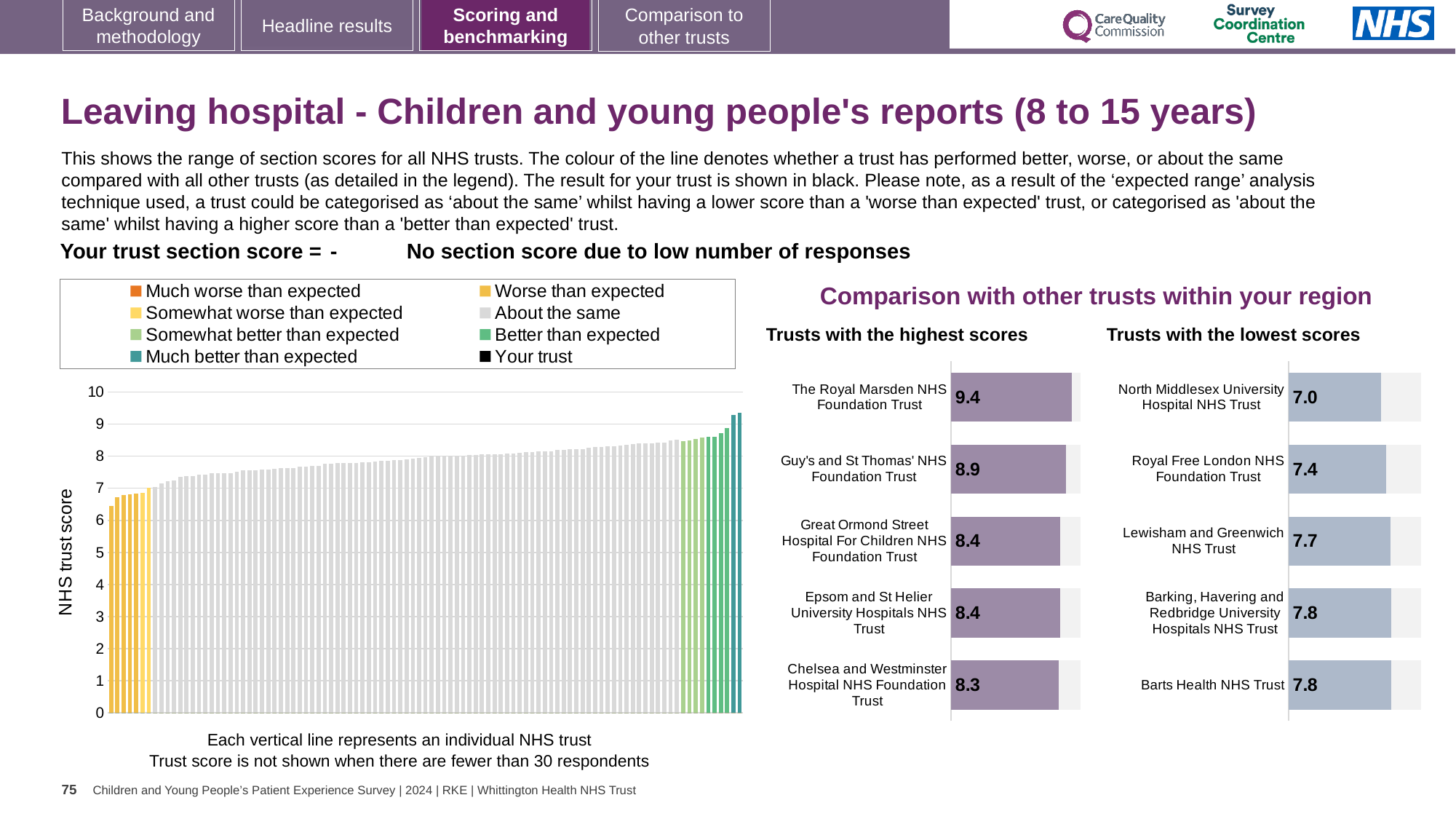
In the 'Trusts with the lowest scores' chart, what is the score for Lewisham and Greenwich NHS Trust? 7.7 In the 'Trusts with the lowest scores' chart, what is the score for North Middlesex University Hospital NHS Trust? 7.0 In the 'Trusts with the lowest scores' chart, which trust has the lowest score? North Middlesex University Hospital NHS Trust In the 'Trusts with the highest scores' chart, what is the difference between the scores of The Royal Marsden NHS Foundation Trust and Chelsea and Westminster Hospital NHS Foundation Trust? 1.1 In the 'Trusts with the lowest scores' chart, what is the difference between the scores of Barts Health NHS Trust and North Middlesex University Hospital NHS Trust? 0.8 In the 'Trusts with the highest scores' chart, which trust has the lowest score shown? Chelsea and Westminster Hospital NHS Foundation Trust How many trusts are listed in the 'Trusts with the highest scores' chart? 5 In the 'Trusts with the lowest scores' chart, which has the higher score: Royal Free London NHS Foundation Trust or Lewisham and Greenwich NHS Trust? Lewisham and Greenwich NHS Trust In the 'Trusts with the highest scores' chart, what is the score for The Royal Marsden NHS Foundation Trust? 9.4 How many entries does the legend of the NHS trust score chart on the left list? 8 In the 'Trusts with the highest scores' chart, what is the score for Guy's and St Thomas' NHS Foundation Trust? 8.9 In the NHS trust score chart on the left, do the trust scores rise or fall from left to right? rise